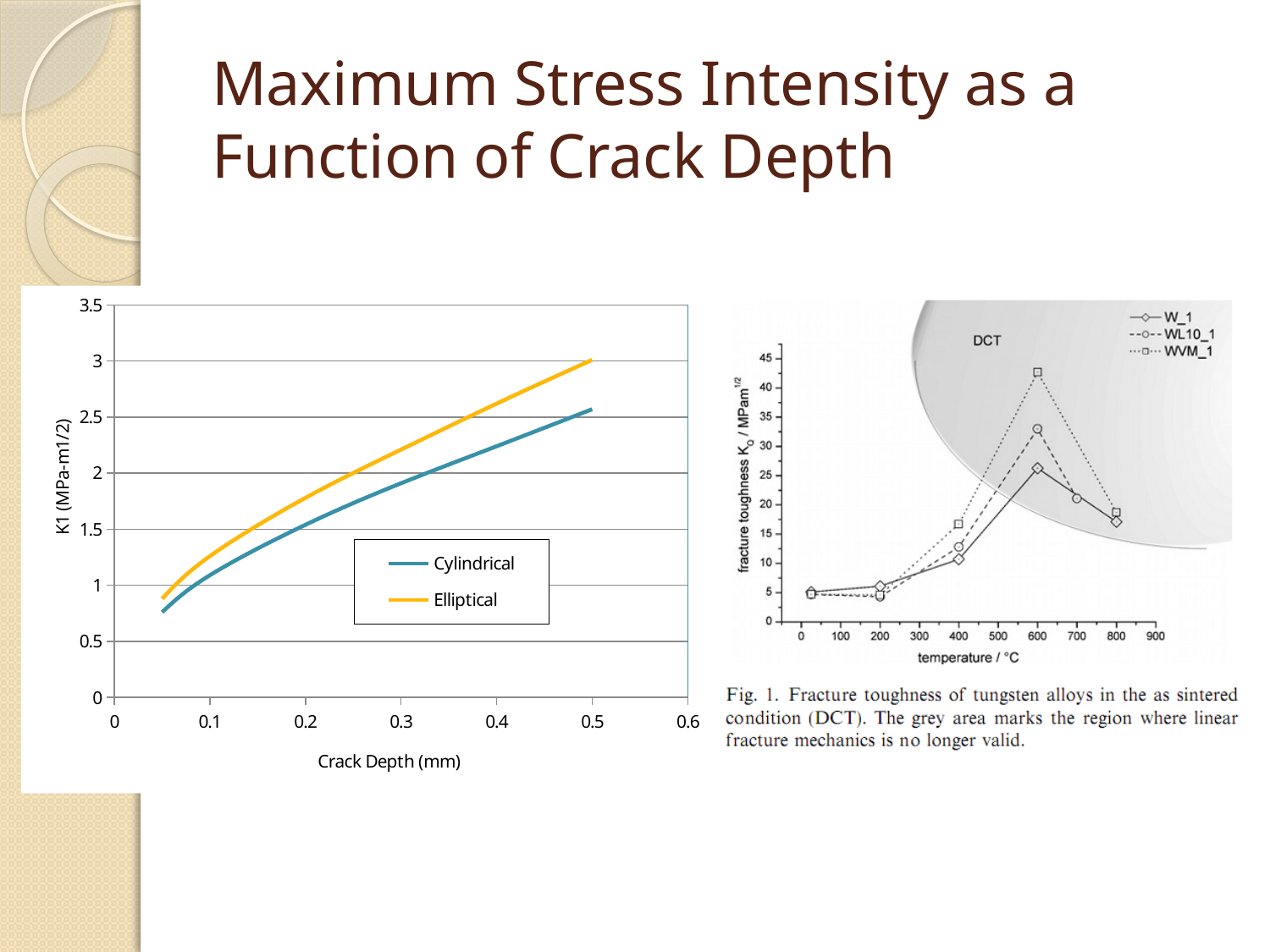
On the left chart, do the K1 values rise or fall as crack depth increases? rise On the left chart, what are the two series named in the legend? Cylindrical and Elliptical On the left chart, is the Cylindrical value at a crack depth of 0.5 mm greater or less than 3? less On the left chart, how many series does the legend list? 2 On the right chart (Fig. 1), which series reaches the highest fracture toughness at 600 °C? WVM_1 On the left chart, which series has the higher K1 value at a crack depth of 0.4 mm, Cylindrical or Elliptical? Elliptical On the right chart (Fig. 1), which series has the lower fracture toughness at 600 °C, W_1 or WL10_1? W_1 On the right chart (Fig. 1), is the WVM_1 value at 600 °C greater or less than 40? greater On the left chart, what is the label of the x axis? Crack Depth (mm) On the right chart (Fig. 1), how many series does the legend list? 3 On the left chart, what kind of chart is it? line chart On the left chart, is the Elliptical value at a crack depth of 0.3 mm greater or less than 2? greater